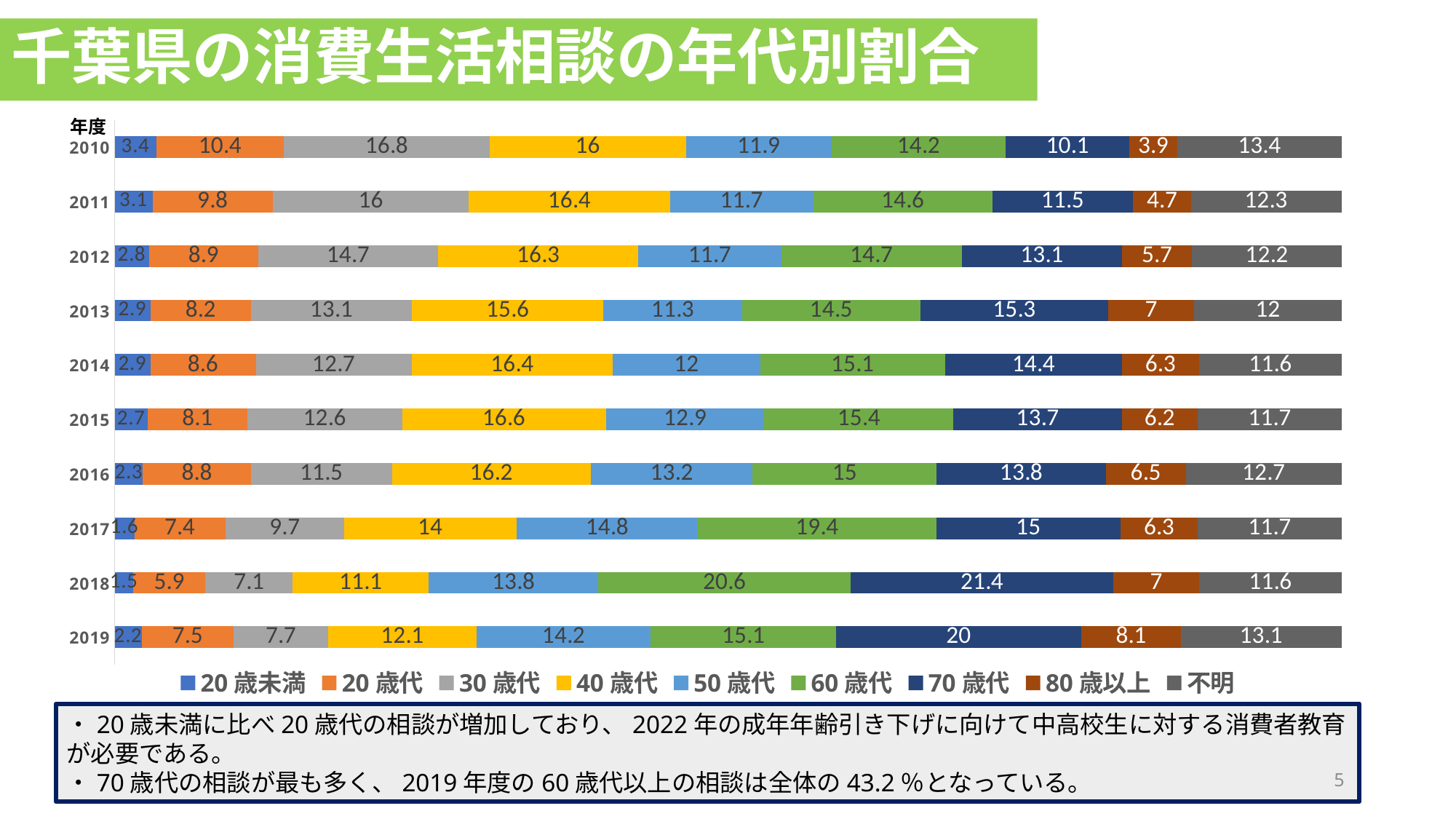
What is the difference between the 70 歳代 and 60 歳代 values in 2018? 0.8 How many years (年度) are shown in the chart? 10 What kind of chart is shown on the slide? Stacked bar chart What is the value for 30 歳代 in 2010? 16.8 Does the 30 歳代 value generally rise or fall from 2010 to 2019? Fall In which year is the 20 歳未満 value the lowest? 2018 What is the value for 70 歳代 in 2019? 20 In which year is the 70 歳代 value the highest? 2018 How many series does the legend list? 9 What is the difference between the 20 歳代 value in 2010 and in 2019? 2.9 In 2017, which is larger: the 60 歳代 value or the 70 歳代 value? 60 歳代 What is the value for 60 歳代 in 2018? 20.6